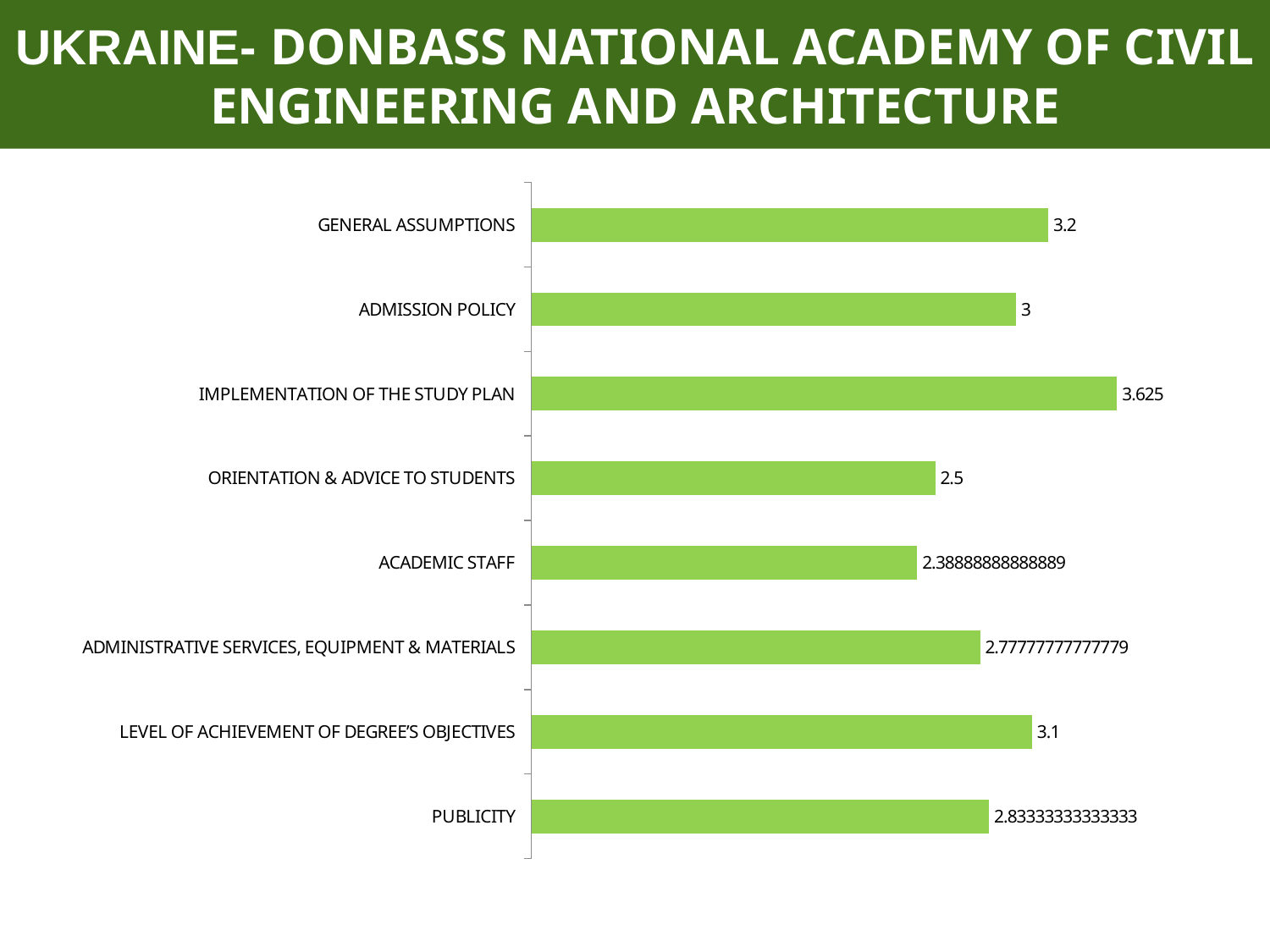
Which category has the lowest value? ACADEMIC STAFF Which category has the highest value? IMPLEMENTATION OF THE STUDY PLAN What is the value for PUBLICITY? 2.83333333333333 What is the difference between the values for GENERAL ASSUMPTIONS and ADMISSION POLICY? 0.2 What is the value for ORIENTATION & ADVICE TO STUDENTS? 2.5 What kind of chart is shown on the slide? Bar chart What is the value for ACADEMIC STAFF? 2.38888888888889 How many categories are shown in the chart? 8 What is the difference between the values for IMPLEMENTATION OF THE STUDY PLAN and ORIENTATION & ADVICE TO STUDENTS? 1.125 What is the value for IMPLEMENTATION OF THE STUDY PLAN? 3.625 Which is larger, the value for LEVEL OF ACHIEVEMENT OF DEGREE'S OBJECTIVES or the value for ADMINISTRATIVE SERVICES, EQUIPMENT & MATERIALS? LEVEL OF ACHIEVEMENT OF DEGREE'S OBJECTIVES What colour are the bars in the chart? Green